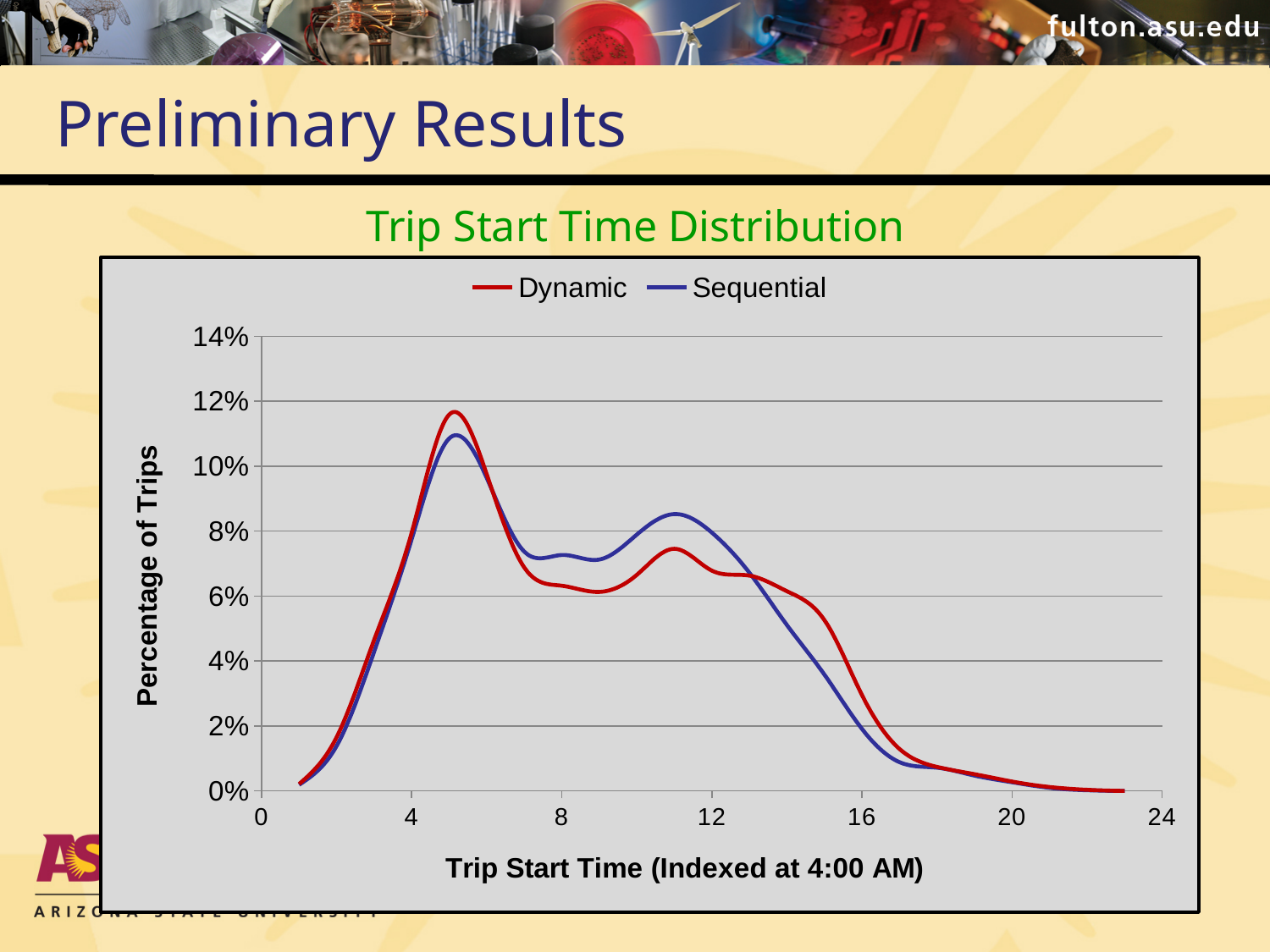
Which series reaches the highest peak value on the chart? Dynamic What are the two series named in the legend? Dynamic and Sequential Is the peak value of the Dynamic series greater or less than 10%? greater What kind of chart is shown on the slide? line chart Between trip start times 12 and 16, do the values of the Sequential series rise or fall? fall What is the title of the chart? Trip Start Time Distribution At trip start time 20, is the Dynamic value greater or less than 2%? less Is the peak value of the Sequential series greater or less than 10%? greater How many series does the legend list? 2 At trip start time 14, which series has the larger value, Dynamic or Sequential? Dynamic At trip start time 11, which series has the larger value, Dynamic or Sequential? Sequential